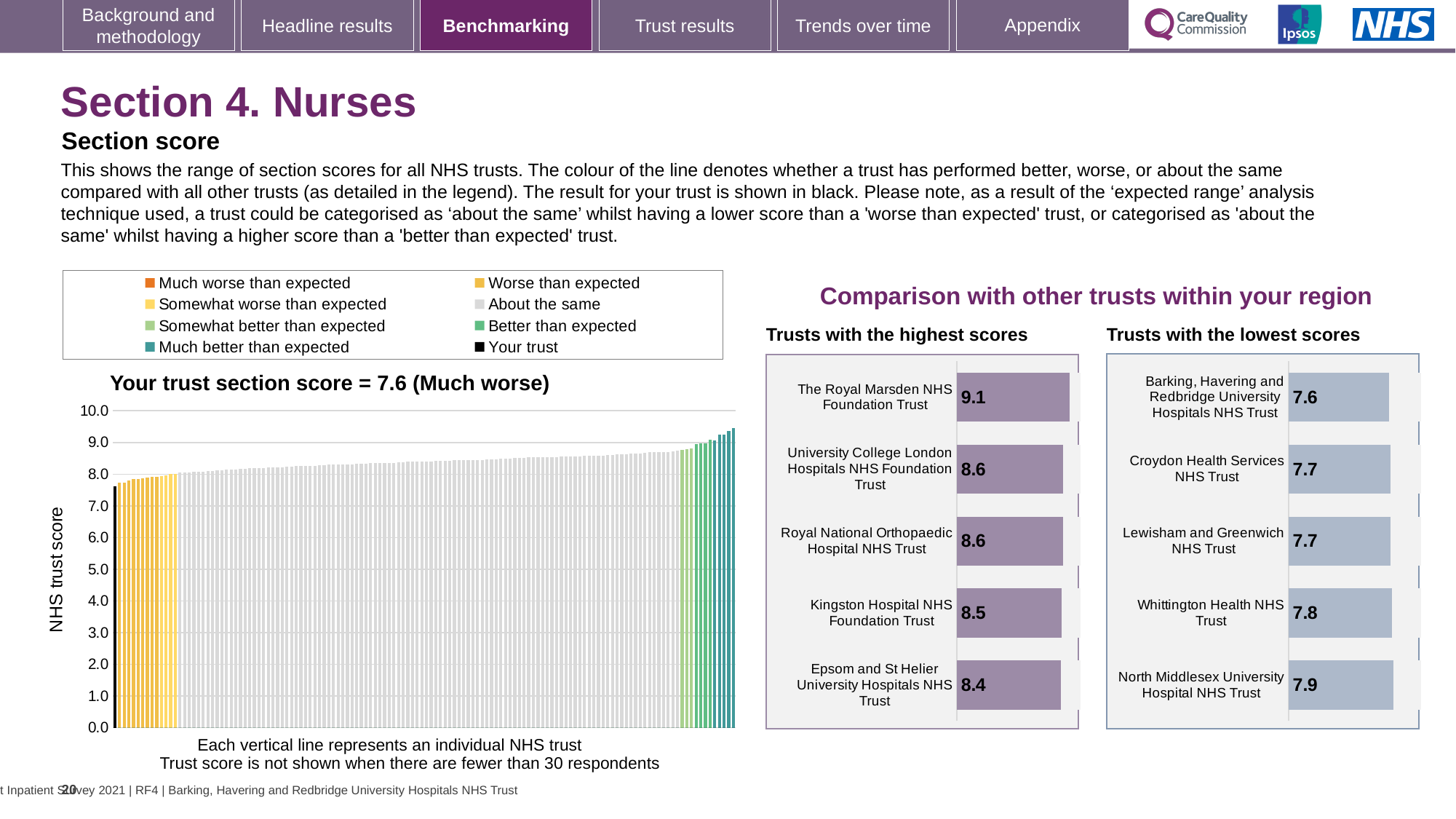
In the 'Trusts with the highest scores' chart, which trust has the highest score? The Royal Marsden NHS Foundation Trust In the 'Trusts with the lowest scores' chart, which trust has the lowest score? Barking, Havering and Redbridge University Hospitals NHS Trust Which has a higher score: Kingston Hospital NHS Foundation Trust in the highest scores chart or Whittington Health NHS Trust in the lowest scores chart? Kingston Hospital NHS Foundation Trust In the 'Trusts with the lowest scores' chart, what is the difference between the scores of North Middlesex University Hospital NHS Trust and Barking, Havering and Redbridge University Hospitals NHS Trust? 0.3 In the 'Trusts with the highest scores' chart, what is the score for The Royal Marsden NHS Foundation Trust? 9.1 In the main section score chart on the left, what is your trust's section score? 7.6 How many entries does the legend above the main section score chart list? 8 In the 'Trusts with the highest scores' chart, what is the difference between the scores of The Royal Marsden NHS Foundation Trust and Epsom and St Helier University Hospitals NHS Trust? 0.7 In the main section score chart on the left, do the trust scores rise or fall from left to right? Rise In the 'Trusts with the lowest scores' chart, what is the score for Croydon Health Services NHS Trust? 7.7 How many trusts are listed in the 'Trusts with the highest scores' chart? 5 What kind of chart is the main section score chart on the left? Bar chart